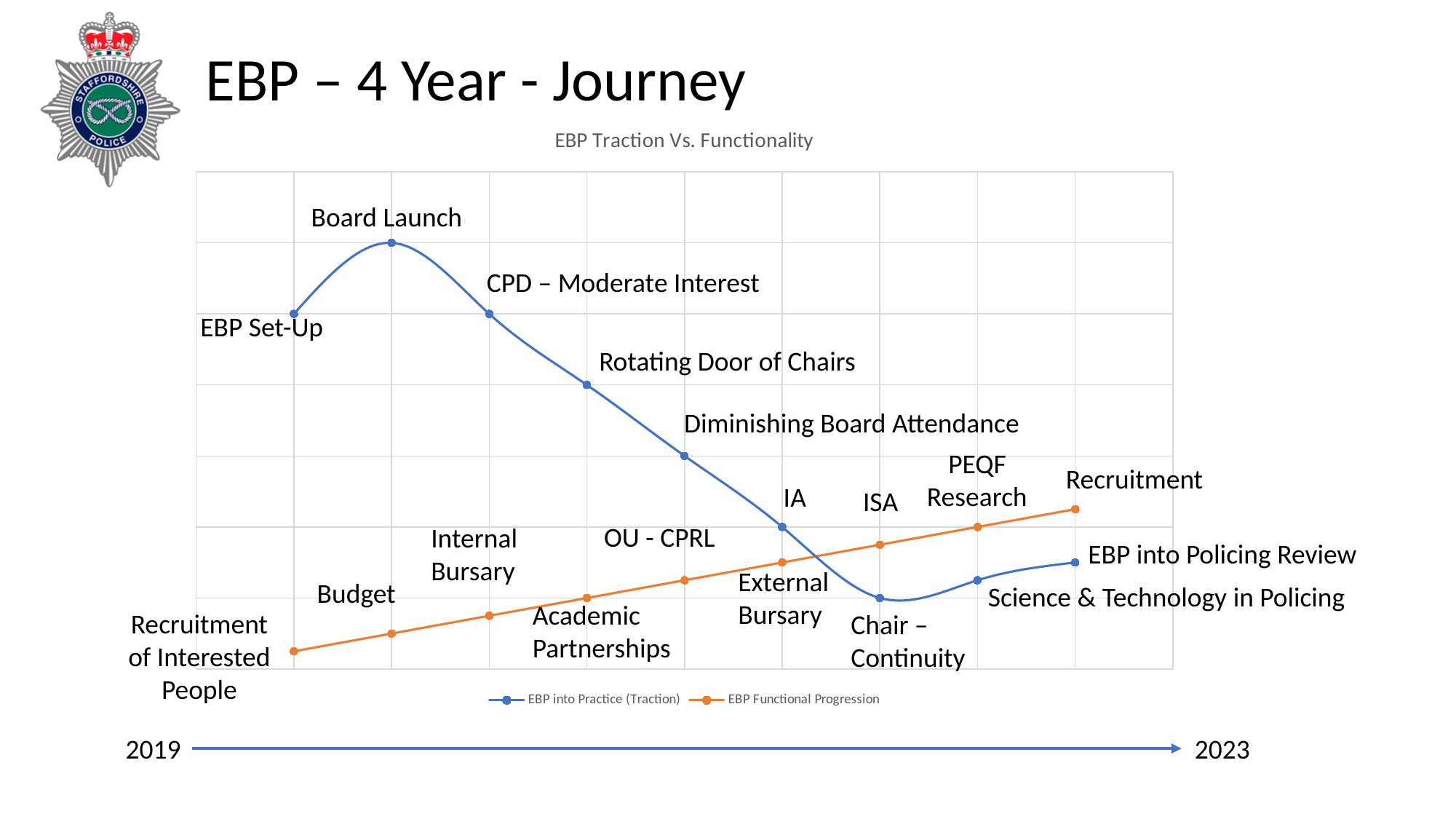
What type of chart is shown on the slide? Line chart How many data points are plotted on the EBP into Practice (Traction) line? 9 Which labelled point on the EBP into Practice (Traction) line is the highest? Board Launch How many series does the chart legend list? 2 Which is higher on the EBP into Practice (Traction) line: Board Launch or EBP Set-Up? Board Launch What is the title of the chart? EBP Traction Vs. Functionality What are the two series named in the chart legend? EBP into Practice (Traction) and EBP Functional Progression How many data points are plotted on the EBP Functional Progression line? 9 At the right-hand end of the chart, which series is higher: EBP into Practice (Traction) or EBP Functional Progression? EBP Functional Progression Does the EBP Functional Progression line rise or fall from left to right? Rises Does the EBP into Practice (Traction) line rise or fall between Board Launch and Chair – Continuity? Falls Which labelled point on the EBP into Practice (Traction) line is the lowest? Chair – Continuity